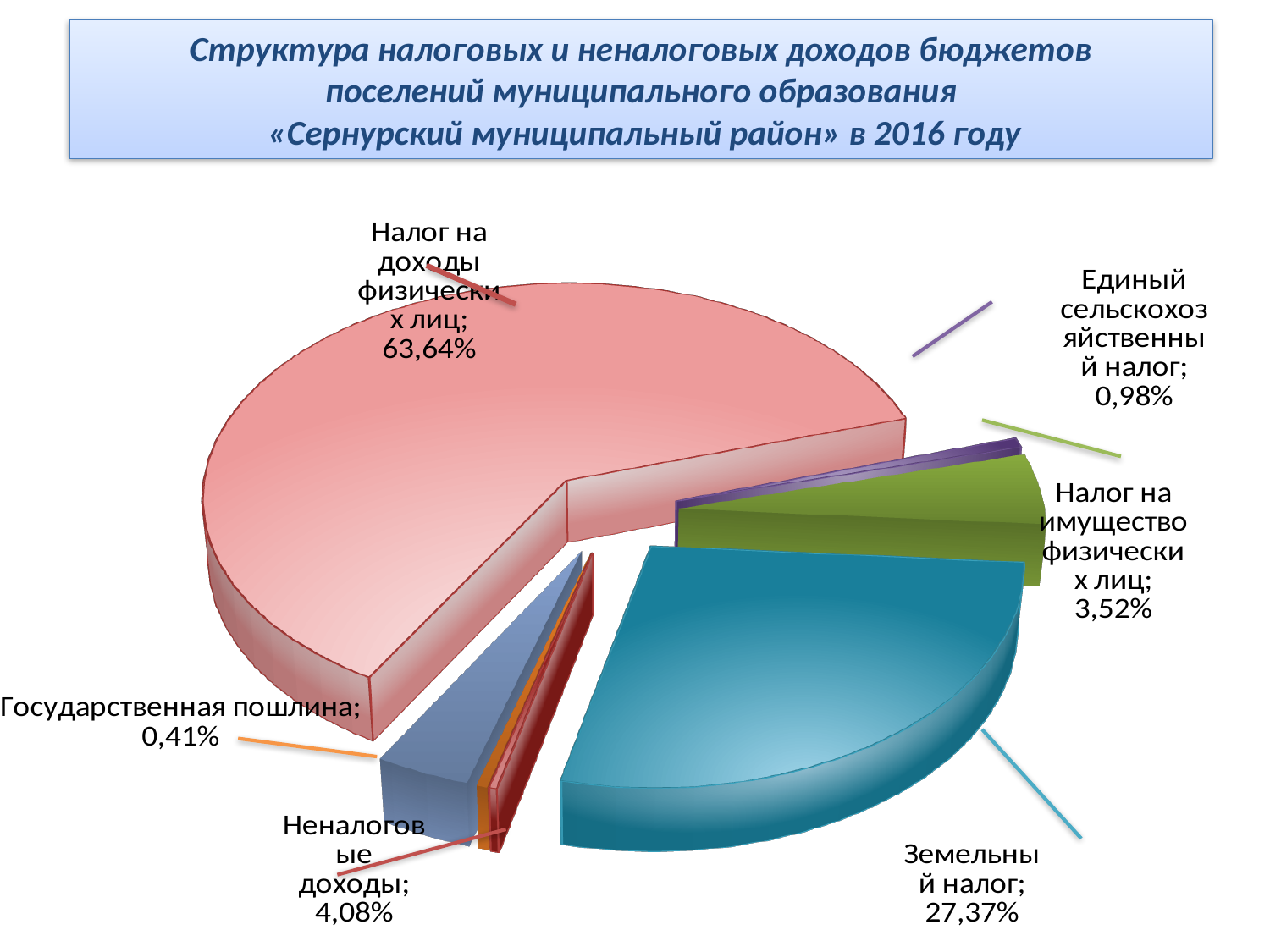
What kind of chart is shown on the slide? Pie chart What share of the pie is labelled for "Налог на доходы физических лиц"? 63,64% Which category has the largest share of the pie? Налог на доходы физических лиц What value is shown for "Неналоговые доходы"? 4,08% What value is shown for "Единый сельскохозяйственный налог"? 0,98% What value is shown for "Земельный налог"? 27,37% What is the difference between the shares of "Налог на доходы физических лиц" and "Земельный налог"? 36,27% How many slices does the pie chart have? 7 Which is larger: the share for "Неналоговые доходы" or for "Налог на имущество физических лиц"? Неналоговые доходы What value is shown for "Налог на имущество физических лиц"? 3,52% What value is shown for "Государственная пошлина"? 0,41%